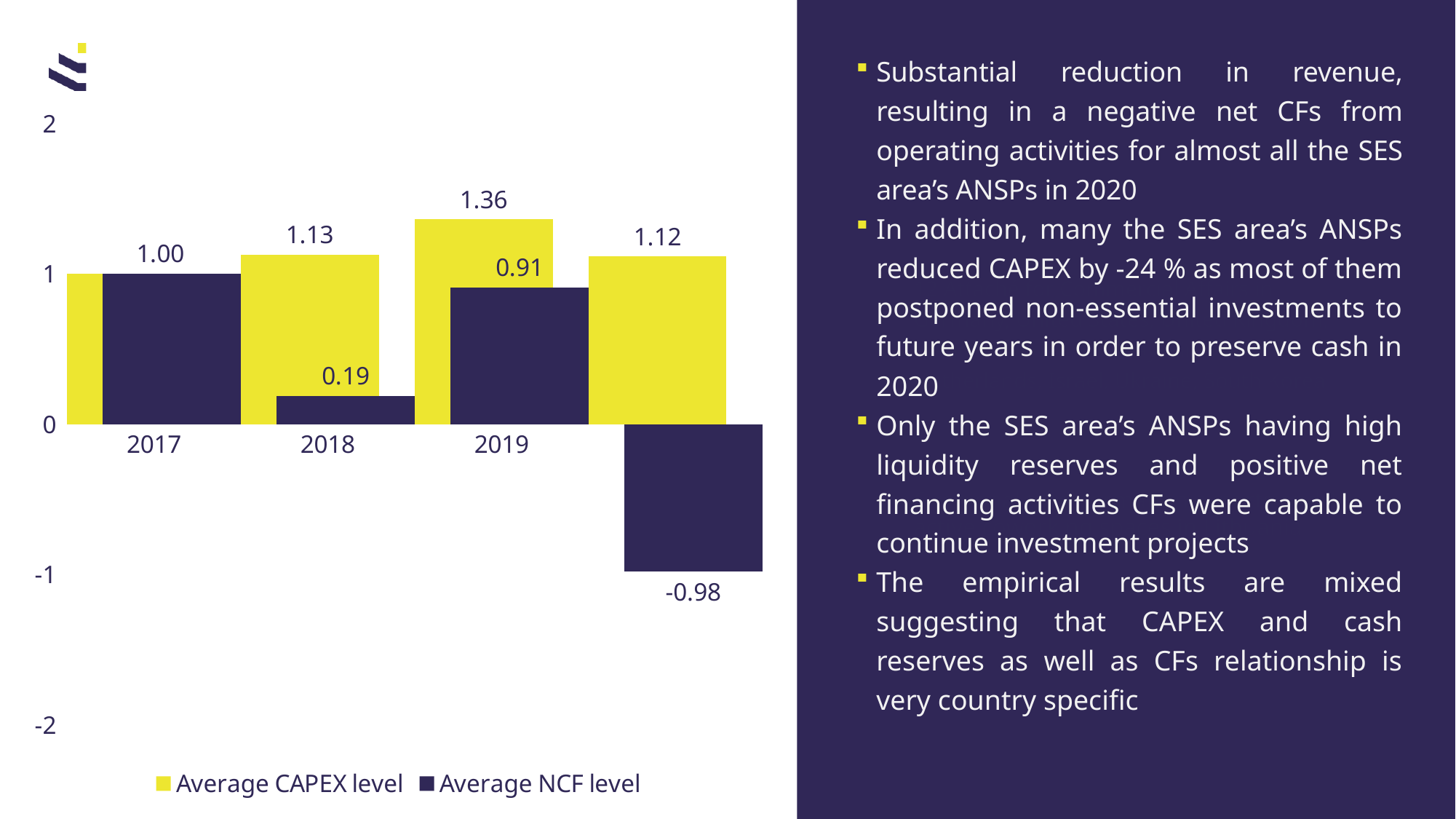
What is the Average NCF level for 2019? 0.91 What is the lowest Average NCF level value shown on the chart? -0.98 What is the difference between the Average CAPEX level in 2019 and in 2018? 0.23 What colour represents the Average CAPEX level series? Yellow What kind of chart is shown on the slide? Bar chart Which year has the highest Average CAPEX level? 2019 How many series does the legend list? 2 What is the Average CAPEX level for 2018? 1.13 Does the Average CAPEX level rise or fall from 2017 to 2019? Rise In 2019, how much higher is the Average CAPEX level than the Average NCF level? 0.45 What is the Average NCF level for 2018? 0.19 Which is larger: the Average NCF level in 2018 or in 2019? 2019